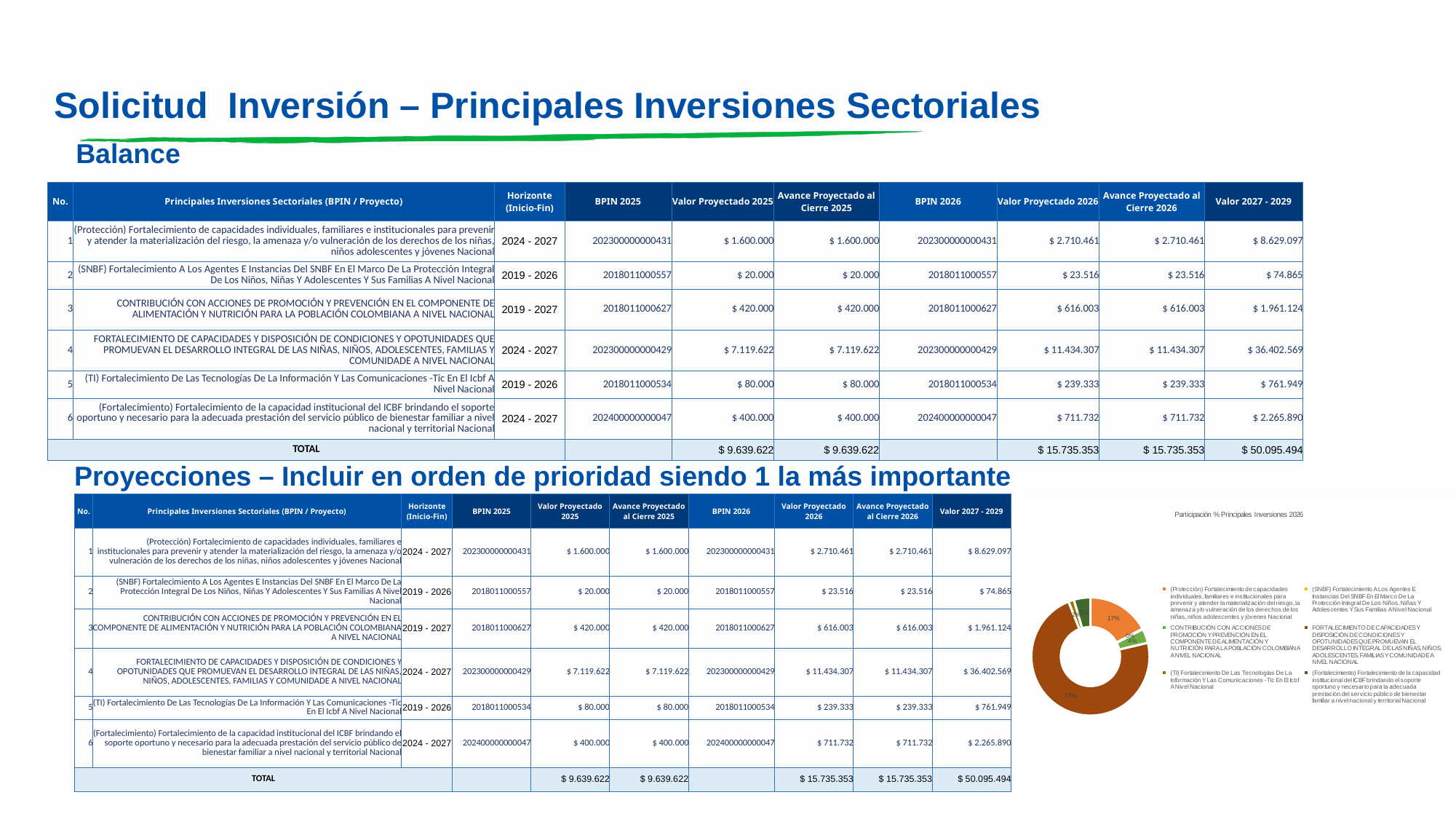
In the 'Participación % Principales Inversiones 2026' chart, what is the share of the largest slice? 73% In the 'Participación % Principales Inversiones 2026' chart, is the largest slice greater or less than 50%? greater What is the title of the chart on the right side of the slide? Participación % Principales Inversiones 2026 How many entries does the legend of the 'Participación % Principales Inversiones 2026' chart list? 6 In the 'Participación % Principales Inversiones 2026' chart, what is the share of the second-largest slice? 17% In the 'Participación % Principales Inversiones 2026' chart, does the largest slice account for more than half of the total? Yes In the 'Participación % Principales Inversiones 2026' chart, what is the difference in percentage points between the 73% slice and the 17% slice? 56 percentage points What kind of chart is shown on the right side of the slide? Pie chart (doughnut) In the 'Participación % Principales Inversiones 2026' chart, which is larger: the 73% slice or the 17% slice? The 73% slice